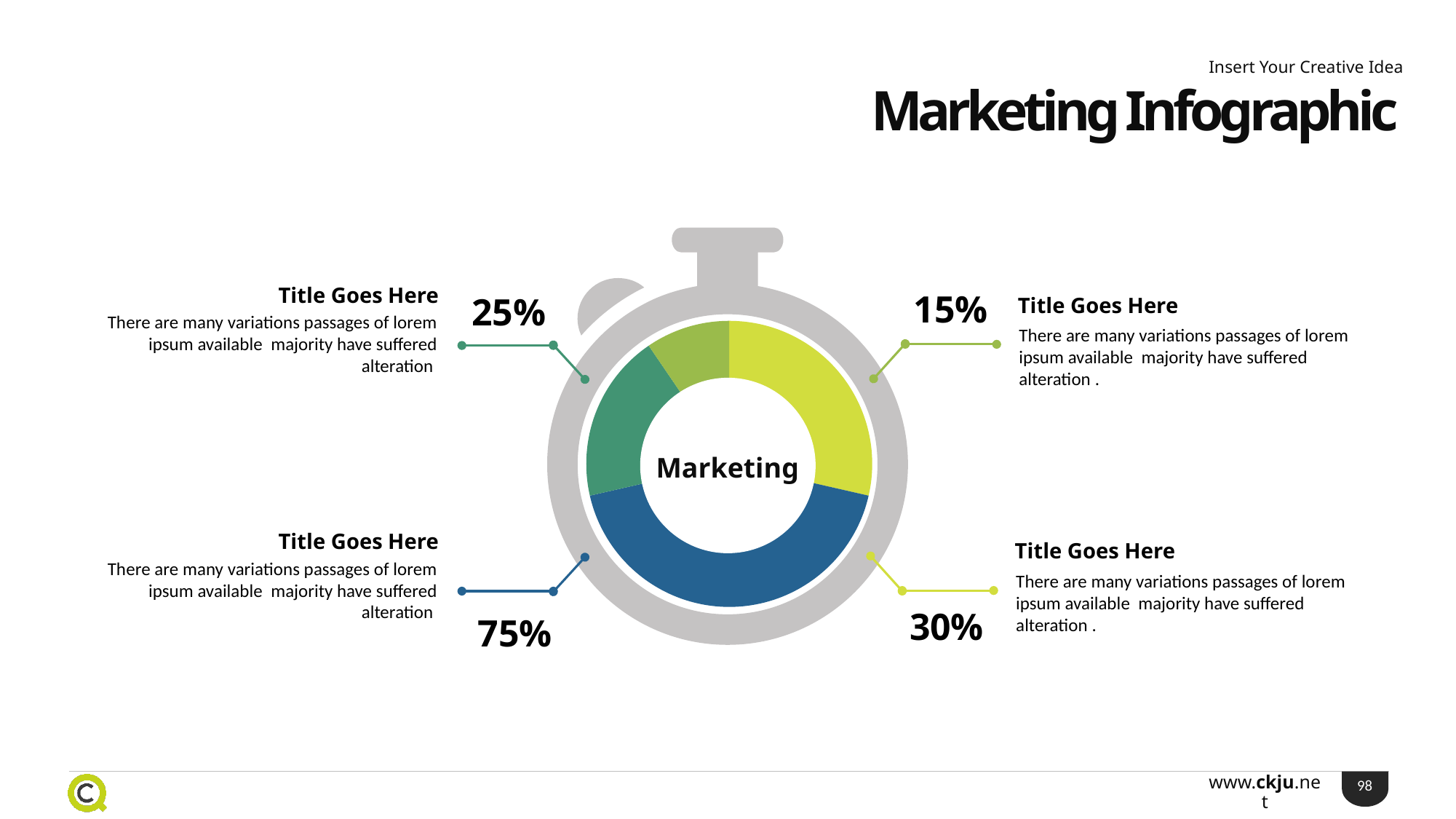
What kind of chart is shown on the slide? donut chart What is the title of the slide containing the donut chart? Marketing Infographic What is the difference between the 75% label and the 30% label? 45% Which is larger, the percentage label at the top-left (25%) or the one at the bottom-right (30%)? 30% What is the largest percentage label shown around the donut chart? 75% How many segments does the donut chart have? 4 How many percentage labels are placed around the donut chart? 4 Which segment of the donut chart is visually the largest? the dark blue segment What percentage label appears at the top-right of the donut chart? 15% What percentage label appears at the bottom-left of the donut chart? 75% What word is written in the centre of the donut chart? Marketing What is the smallest percentage label shown around the donut chart? 15%